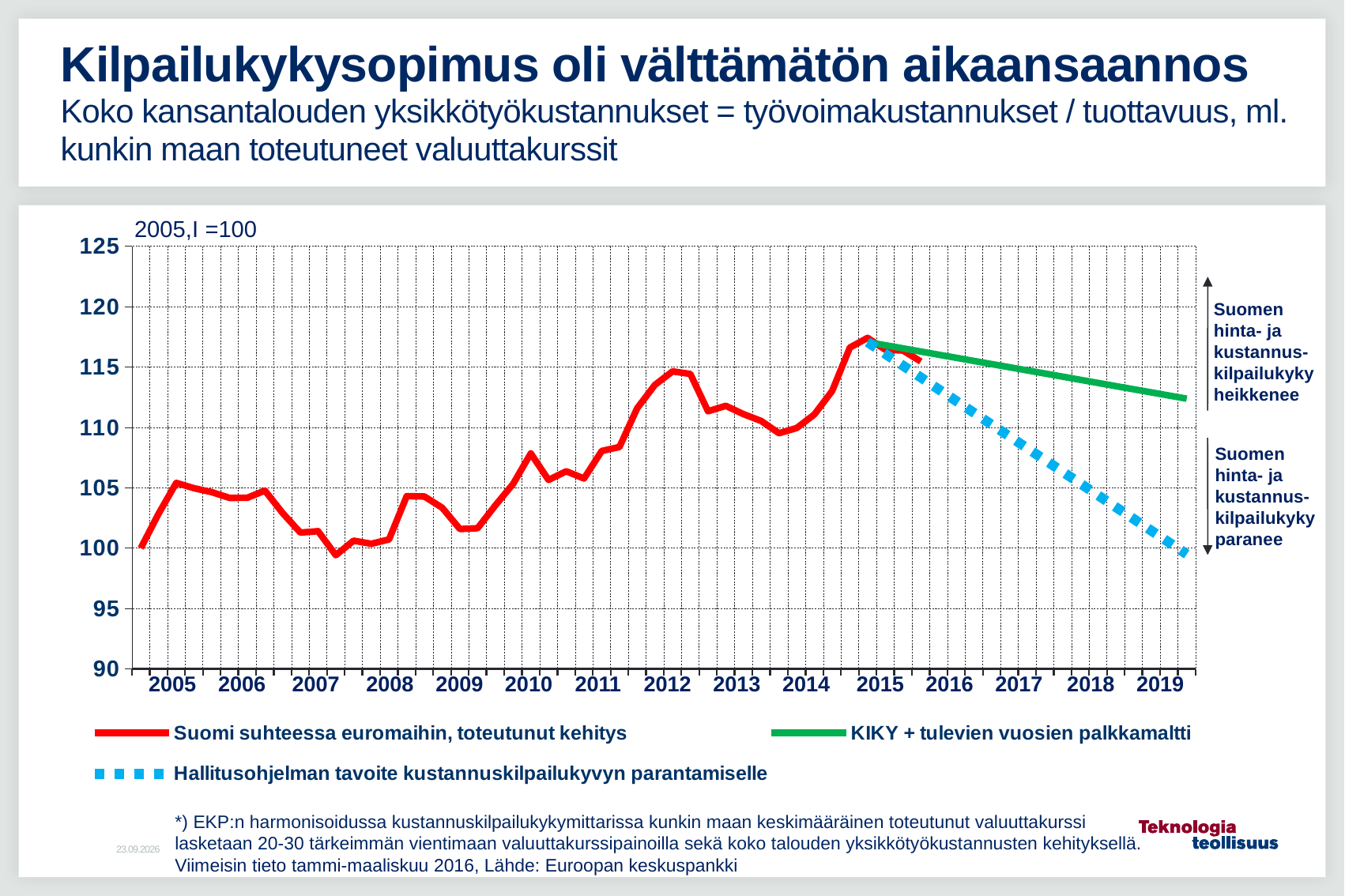
What is the legend label of the solid red line? Suomi suhteessa euromaihin, toteutunut kehitys Is the value of the red line in 2009 greater or less than 105? less What type of chart is shown on the slide? line chart What is the legend label of the green line? KIKY + tulevien vuosien palkkamaltti Is the value of the blue dotted line at the end of 2019 greater or less than 105? less At the end of 2019, which line is higher: the green line or the blue dotted line? the green line Is the value of the red line in 2012 greater or less than 110? greater How many years are labeled on the x axis? 15 How many series does the legend list? 3 Does the blue dotted line rise or fall from 2015 to 2019? fall What is the value of the red line at the start of 2005 (the index base)? 100